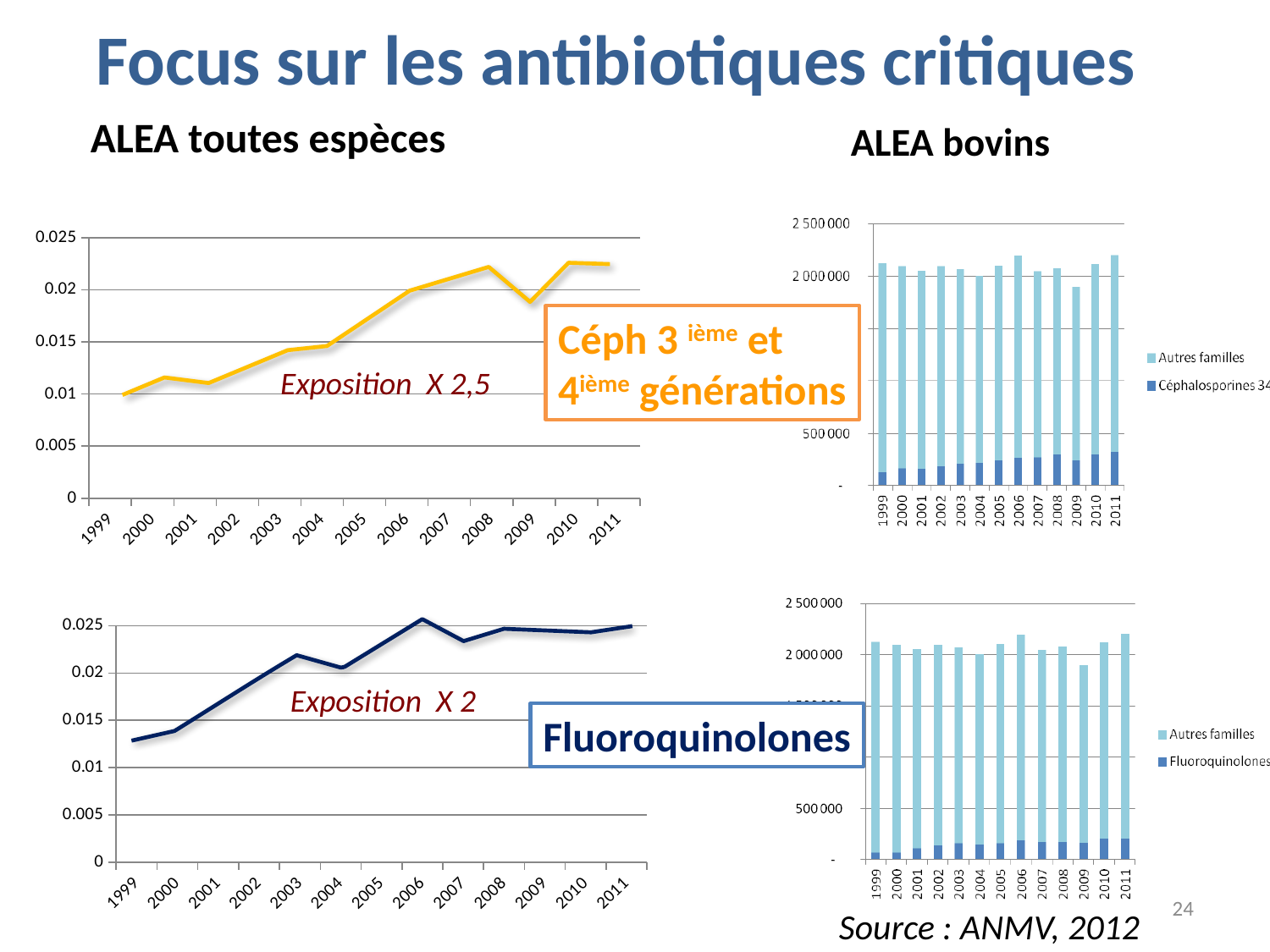
In the top-left line chart (Céph 3ième et 4ième générations), is the value for 2009 greater or less than 0.02? less In the bottom-left line chart (Fluoroquinolones), do the values generally rise or fall from 1999 to 2011? rise In the bottom-left line chart (Fluoroquinolones), which year has the highest value? 2006 What kind of chart is the top-right chart under 'ALEA bovins'? stacked bar chart In the top-left line chart (Céph 3ième et 4ième générations), which year has the lowest value? 1999 In the top-left line chart (Céph 3ième et 4ième générations), how many years are shown on the x axis? 13 In the bottom-left line chart (Fluoroquinolones), which year has the lowest value? 1999 In the bottom-right stacked bar chart (ALEA bovins, Fluoroquinolones), which year has the lowest total bar? 2009 In the bottom-right stacked bar chart (ALEA bovins, Fluoroquinolones), how many series does the legend list? 2 In the top-left line chart (Céph 3ième et 4ième générations), is the value for 2011 greater or less than 0.02? greater In the bottom-left line chart (Fluoroquinolones), is the value for 2003 greater or less than 0.02? greater What kind of chart is the top-left chart under 'ALEA toutes espèces'? line chart